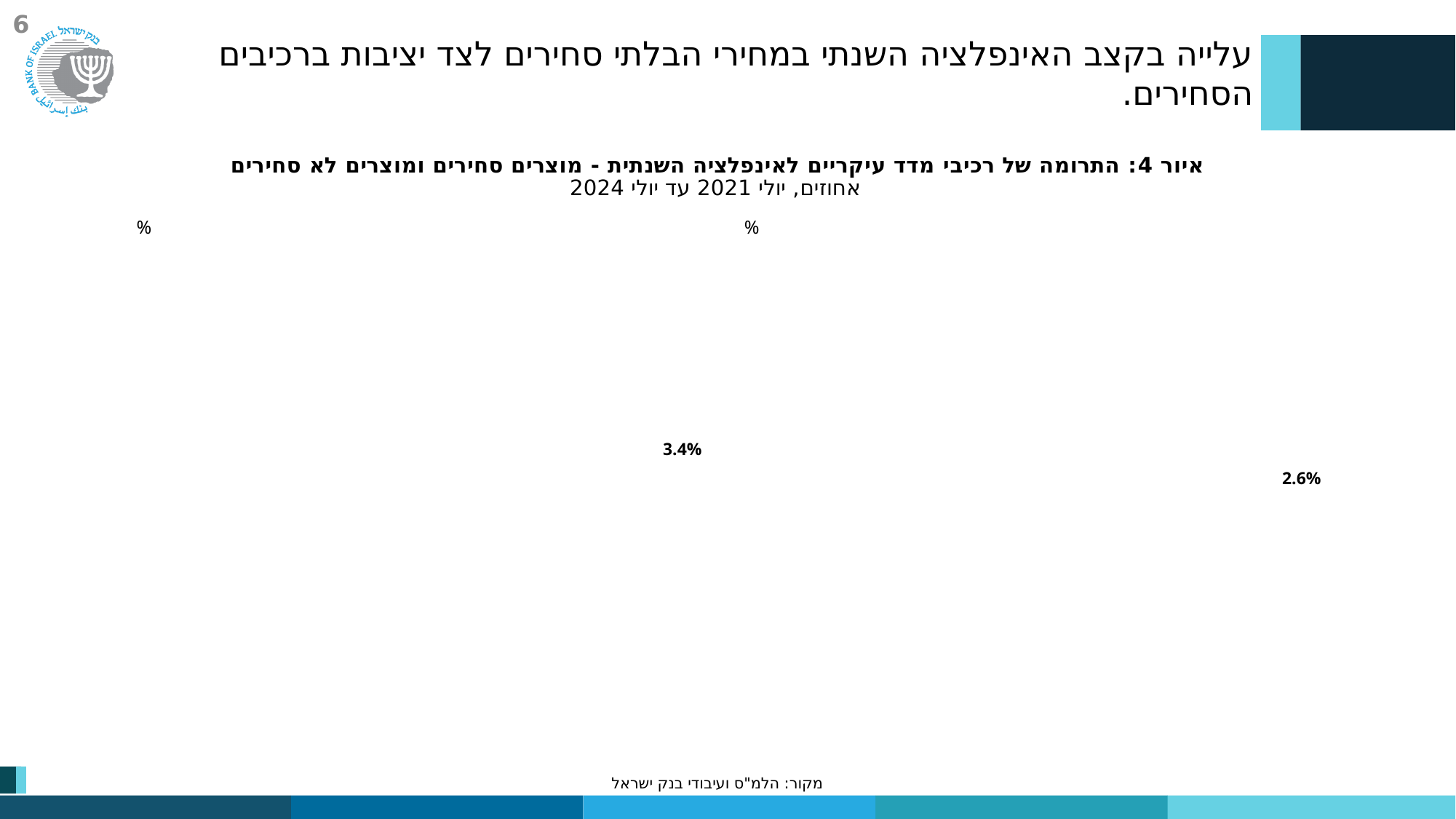
Which is the larger of the two data labels printed on the chart, 3.4% or 2.6%? 3.4% What is the title of the chart on the slide? איור 4: התרומה של רכיבי מדד עיקריים לאינפלציה השנתית - מוצרים סחירים ומוצרים לא סחירים What period does the chart's subtitle say the data covers? יולי 2021 עד יולי 2024 Is the data label 2.6% on the chart greater or less than 3? less How many data labels are printed on the chart? 2 What is the difference between the two data labels printed on the chart, 3.4% and 2.6%? 0.8% Is the data label 3.4% on the chart greater or less than 3? greater